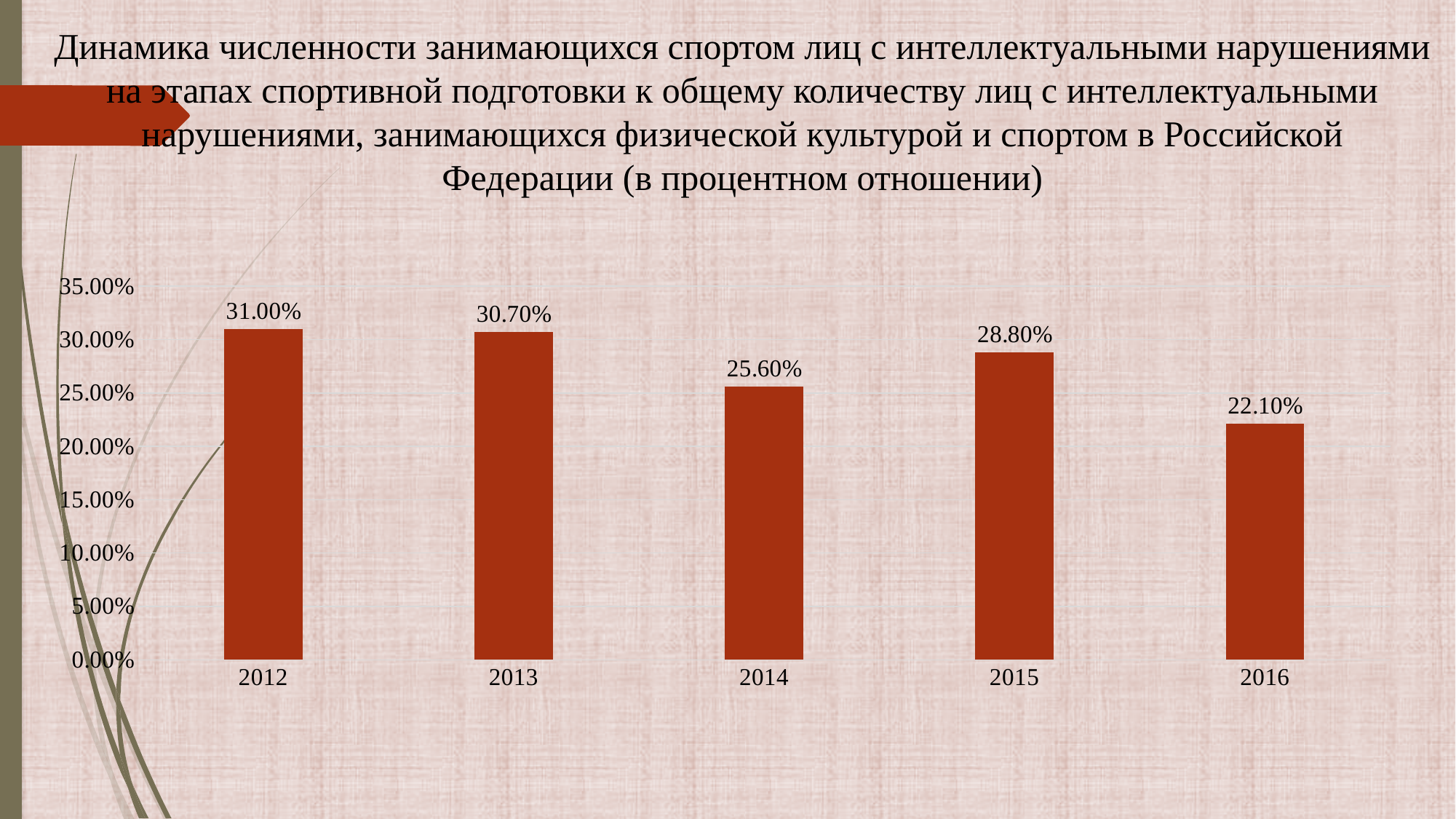
Does the value rise or fall from 2015 to 2016? fall How many years are shown on the x axis? 5 What is the value for 2014? 25.60% Which year has the lowest value? 2016 What is the difference between the values for 2012 and 2016? 8.90% What is the difference between the values for 2015 and 2014? 3.20% What kind of chart is shown on the slide? bar chart Is the value for 2013 greater or less than 30.00%? greater What is the value for 2012? 31.00% Which is larger, the value for 2014 or the value for 2015? 2015 Which year has the highest value? 2012 What is the value for 2016? 22.10%